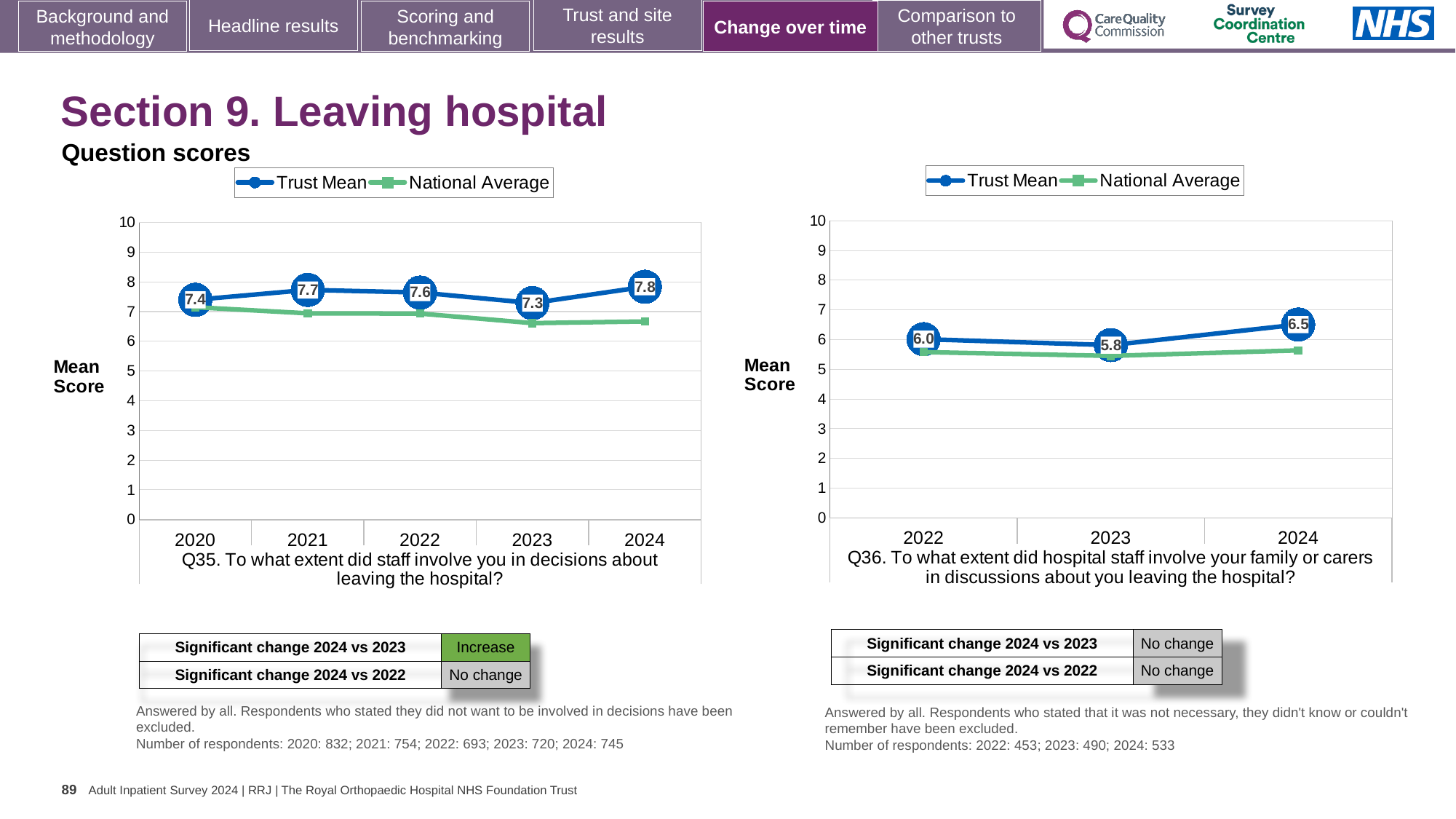
In the Q36 chart (right), what is the Trust Mean score for 2023? 5.8 In the Q35 chart (left), what is the difference between the Trust Mean scores for 2024 and 2023? 0.5 In the Q35 chart (left), is the National Average for 2023 greater or less than 7? less In the Q36 chart (right), how many series does the legend list? 2 In the Q35 chart (left), which year has the highest Trust Mean score? 2024 What type of chart is used for Q36 (right)? Line chart In the Q36 chart (right), which year has the highest Trust Mean score? 2024 In the Q35 chart (left), what is the Trust Mean score for 2024? 7.8 In the Q35 chart (left), which year has the lowest Trust Mean score? 2023 In the Q35 chart (left), what is the Trust Mean score for 2020? 7.4 In the Q36 chart (right), what is the difference between the Trust Mean scores for 2024 and 2022? 0.5 In the Q35 chart (left), how many years are plotted on the x axis? 5